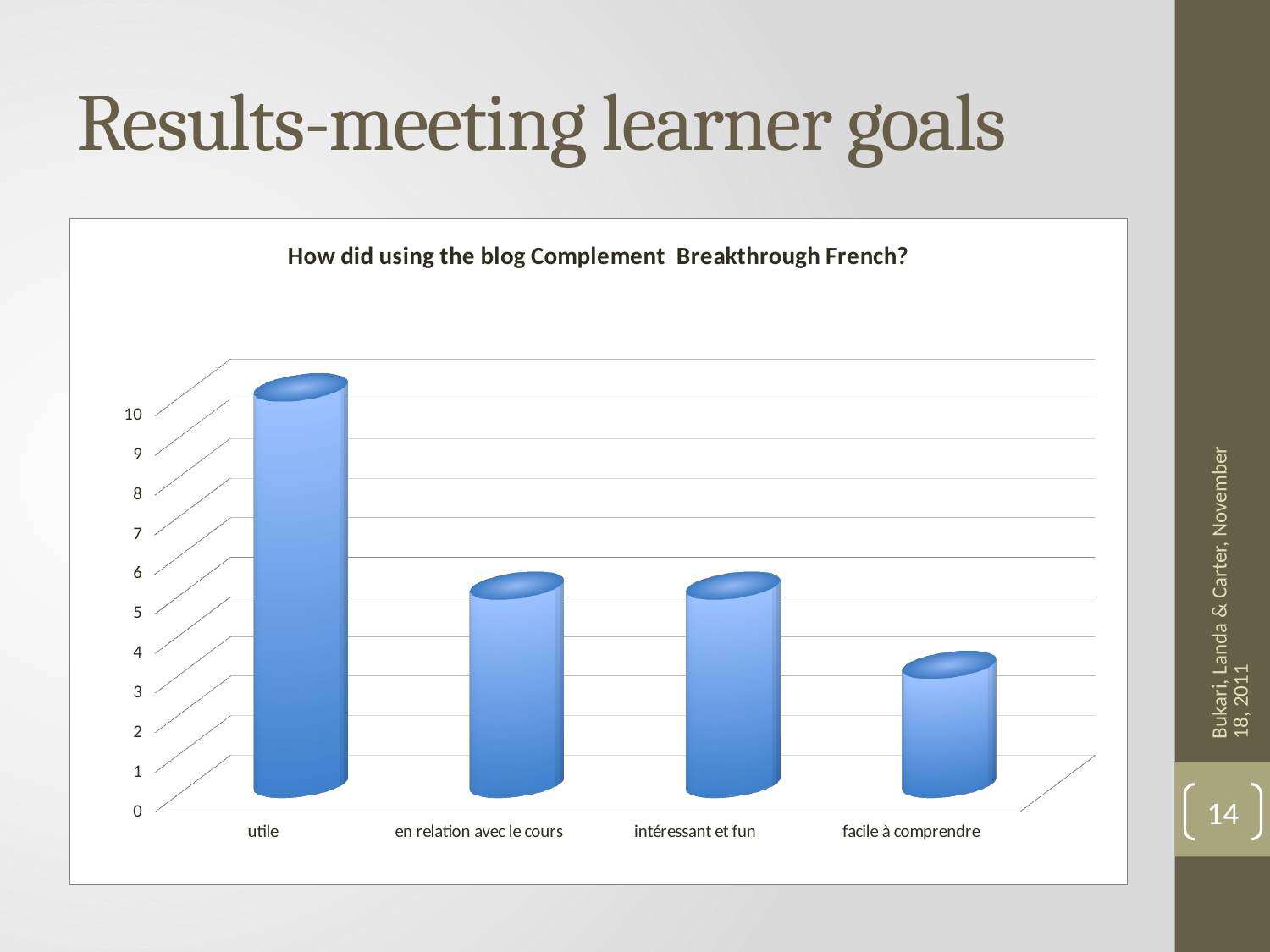
What is the title of the chart? How did using the blog Complement Breakthrough French? Is the value for facile à comprendre greater or less than 5? less Is the value for utile greater or less than 8? greater What kind of chart is shown on the slide? bar chart Which category has the highest value in the chart? utile Is the value for en relation avec le cours greater or less than 7? less Which is larger, the value for utile or the value for en relation avec le cours? utile Which category has the lowest value in the chart? facile à comprendre How many categories are shown on the x axis of the chart? 4 Which is larger, the value for utile or the value for facile à comprendre? utile What is the highest tick value shown on the vertical axis of the chart? 10